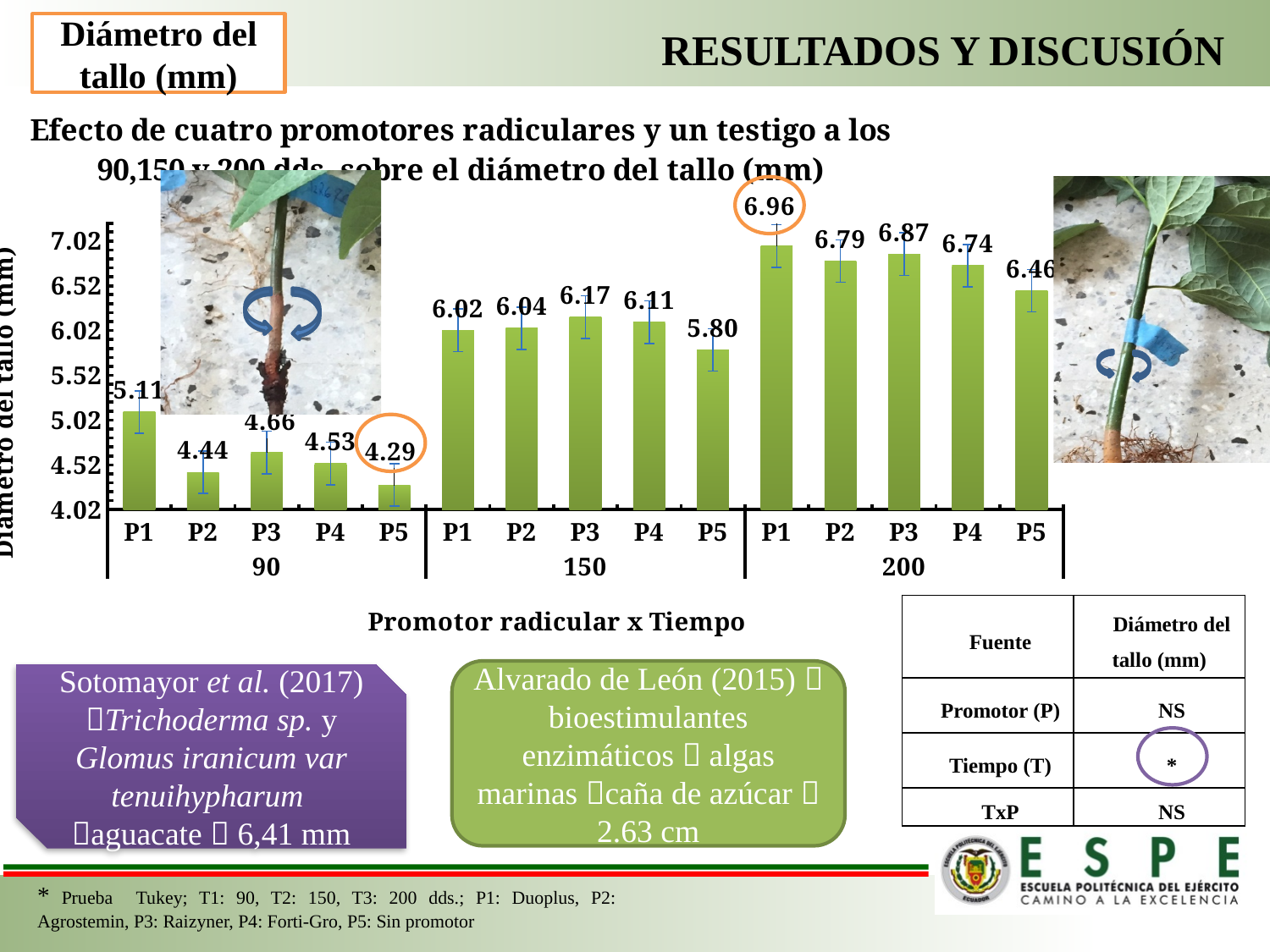
What is the value for P5 at 200 dds? 6.46 Which bar has the lowest value in the chart? P5 at 90 What kind of chart is shown on the slide? bar chart What is the value for P1 at 90 dds? 5.11 What is the value for P3 at 150 dds? 6.17 Is the value for P5 at 150 dds greater or less than 6.02? less Which bar has the highest value in the chart? P1 at 200 What is the x-axis title of the chart? Promotor radicular x Tiempo Do the values for P1 rise or fall from 90 to 200 dds? rise How many bars are plotted in the chart? 15 Which is larger, P2 at 200 dds or P3 at 200 dds? P3 at 200 dds What is the difference between P1 at 200 dds and P5 at 90 dds? 2.67